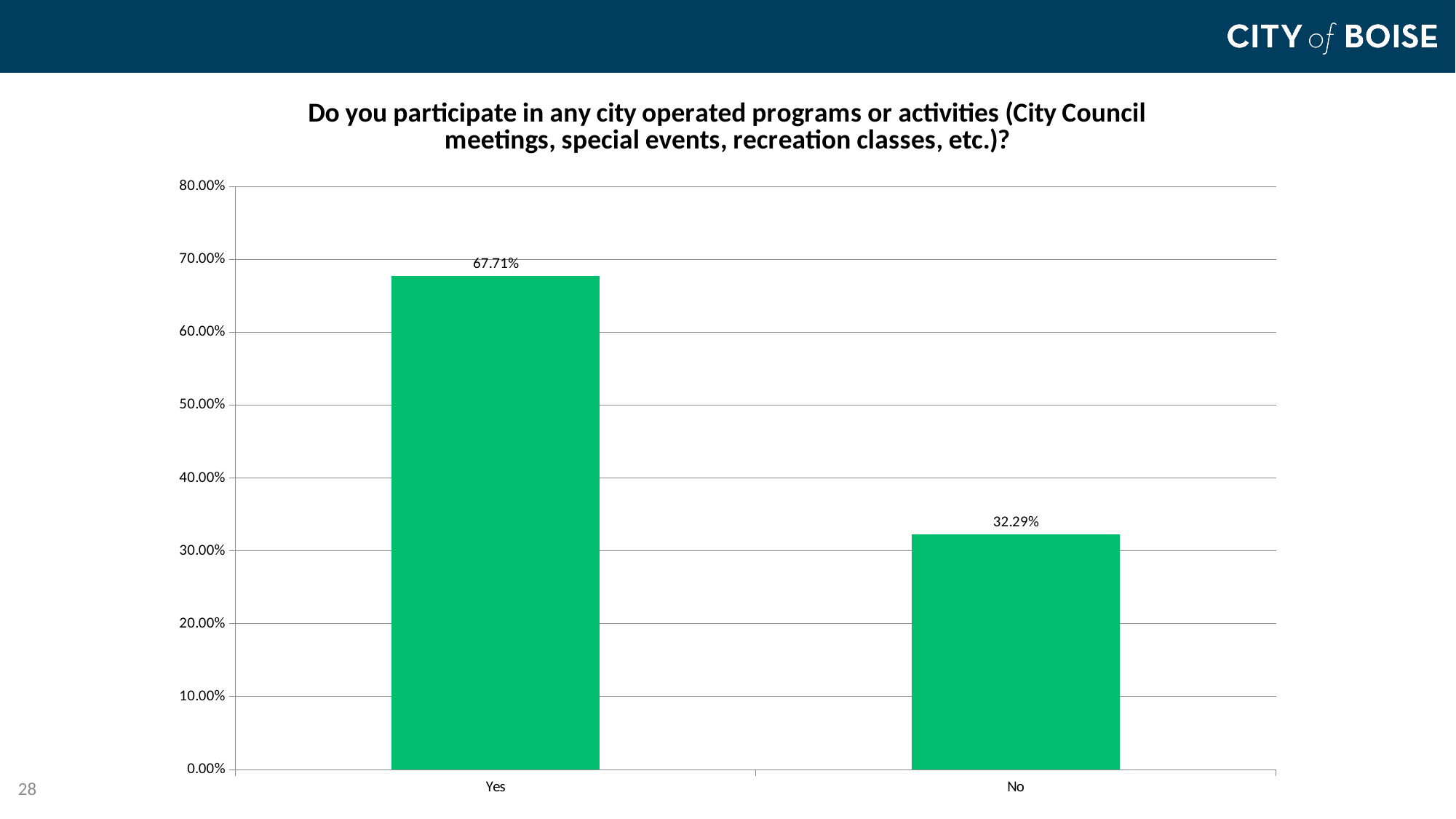
What colour are the bars in the chart? Green Which response has the highest value? Yes Is the value for Yes greater or less than 60.00%? greater Which is larger, the value for Yes or the value for No? Yes What percentage of respondents answered No? 32.29% Is the value for No greater or less than 40.00%? less Which response has the lowest value? No What percentage of respondents answered Yes? 67.71% What is the difference in percentage points between the Yes and No responses? 35.42 What kind of chart is shown on the slide? Bar chart How many response categories are shown on the chart? 2 What is the highest value shown on the vertical axis? 80.00%